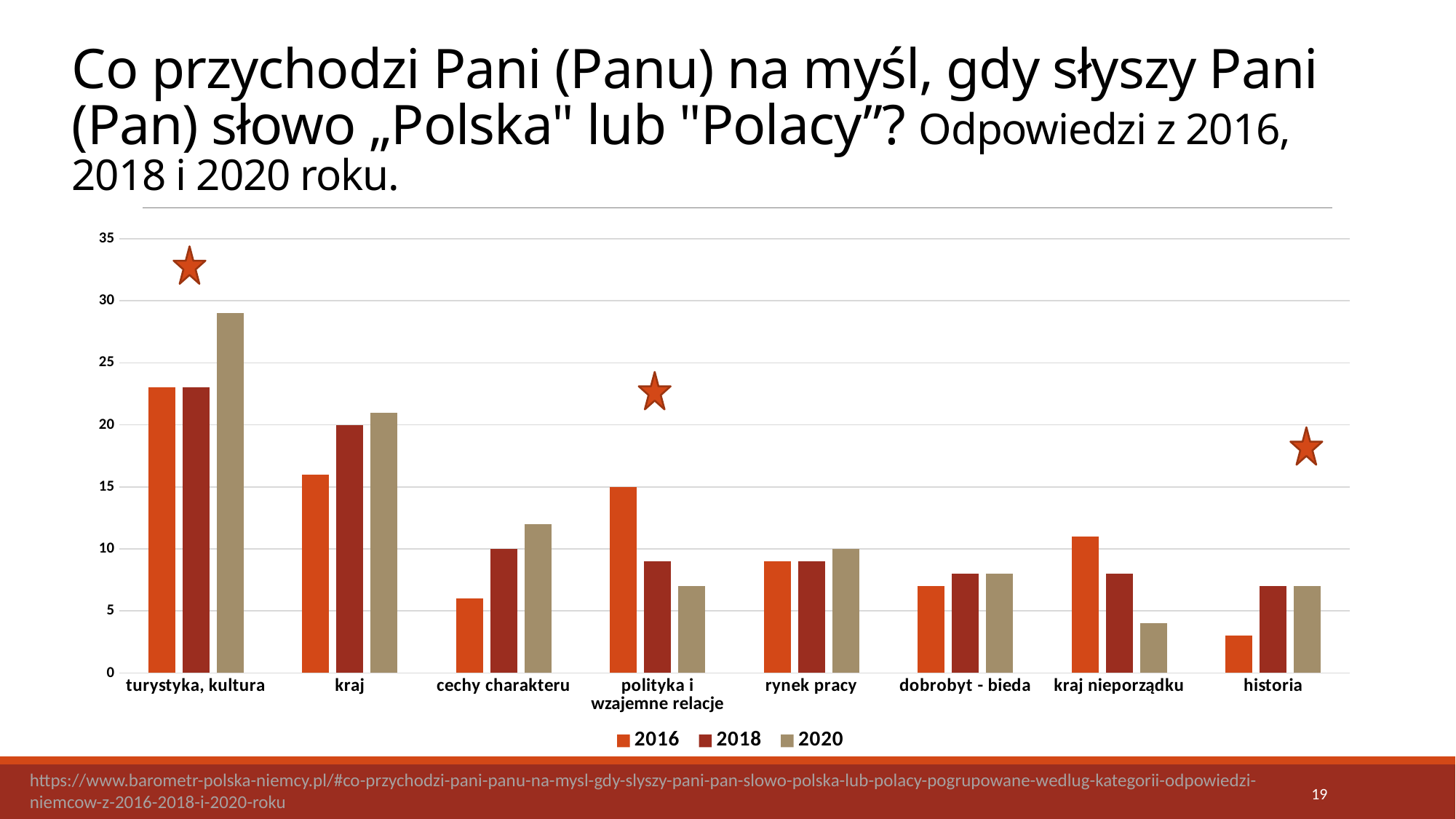
Which category has the lowest value in the 2016 series? historia What is the value for kraj in the 2018 series? 20 What is the value for rynek pracy in the 2020 series? 10 What is the value for polityka i wzajemne relacje in the 2016 series? 15 How many series does the legend list? 3 How many categories are shown on the x axis? 8 Which category has the highest value in the 2020 series? turystyka, kultura Is the value for turystyka, kultura in 2020 greater or less than 25? greater Do the values for kraj nieporządku rise or fall from 2016 to 2020? fall What kind of chart is shown on the slide? bar chart Which is larger in the 2020 series: kraj or cechy charakteru? kraj Is the value for kraj nieporządku in 2020 greater or less than 5? less